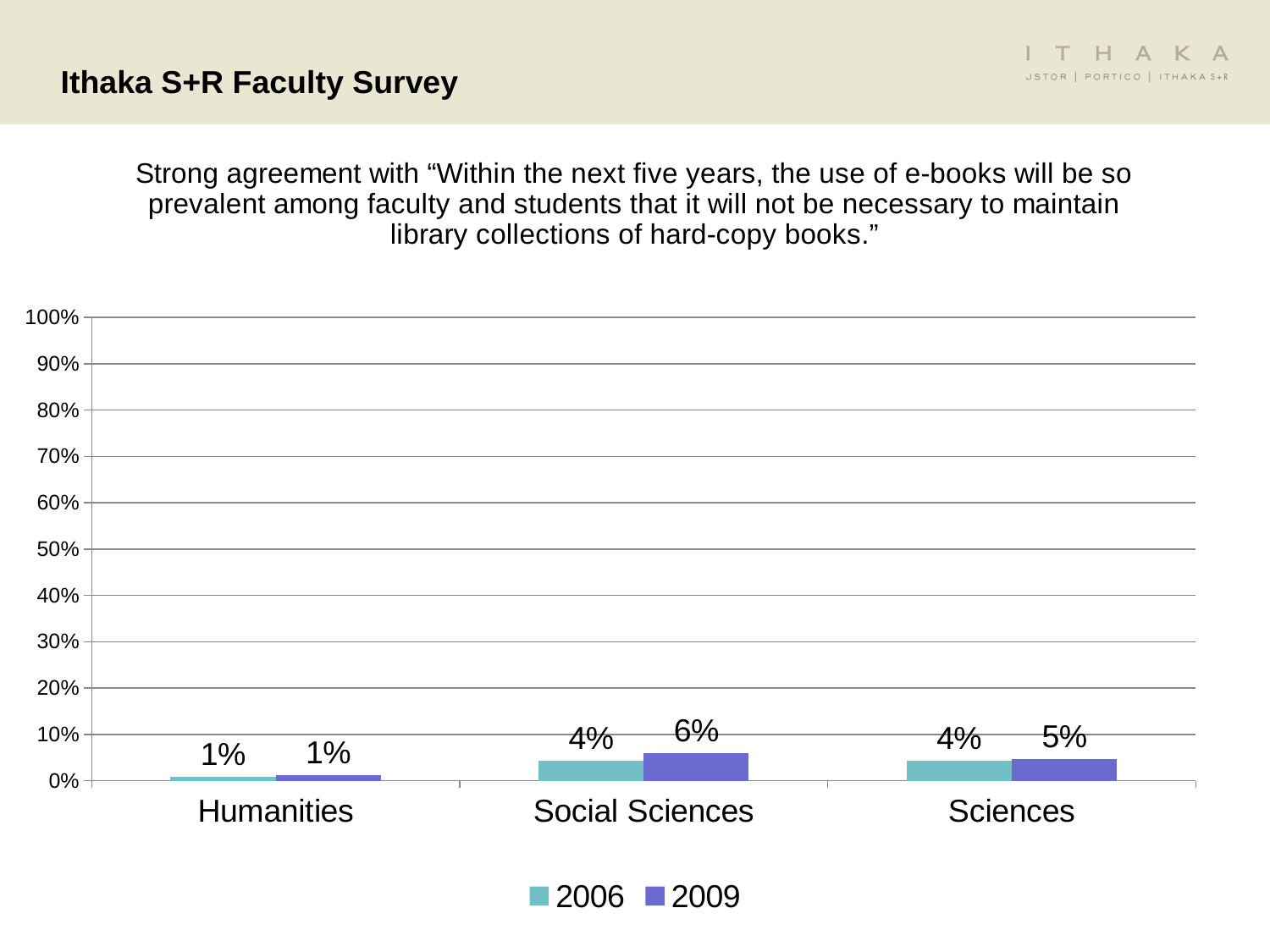
How many categories are shown on the x axis? 3 Which category has the highest 2009 value? Social Sciences What is the 2006 value for Sciences? 4% What is the difference between the 2009 and 2006 values for Social Sciences? 2% Is the 2009 value for Social Sciences greater or less than 10%? less What kind of chart is shown on the slide? bar chart What is the 2009 value for Sciences? 5% Which is larger for Sciences, the 2006 value or the 2009 value? 2009 What is the 2009 value for Social Sciences? 6% What is the 2006 value for Humanities? 1% Which category has the lowest 2006 value? Humanities How many series does the legend list? 2